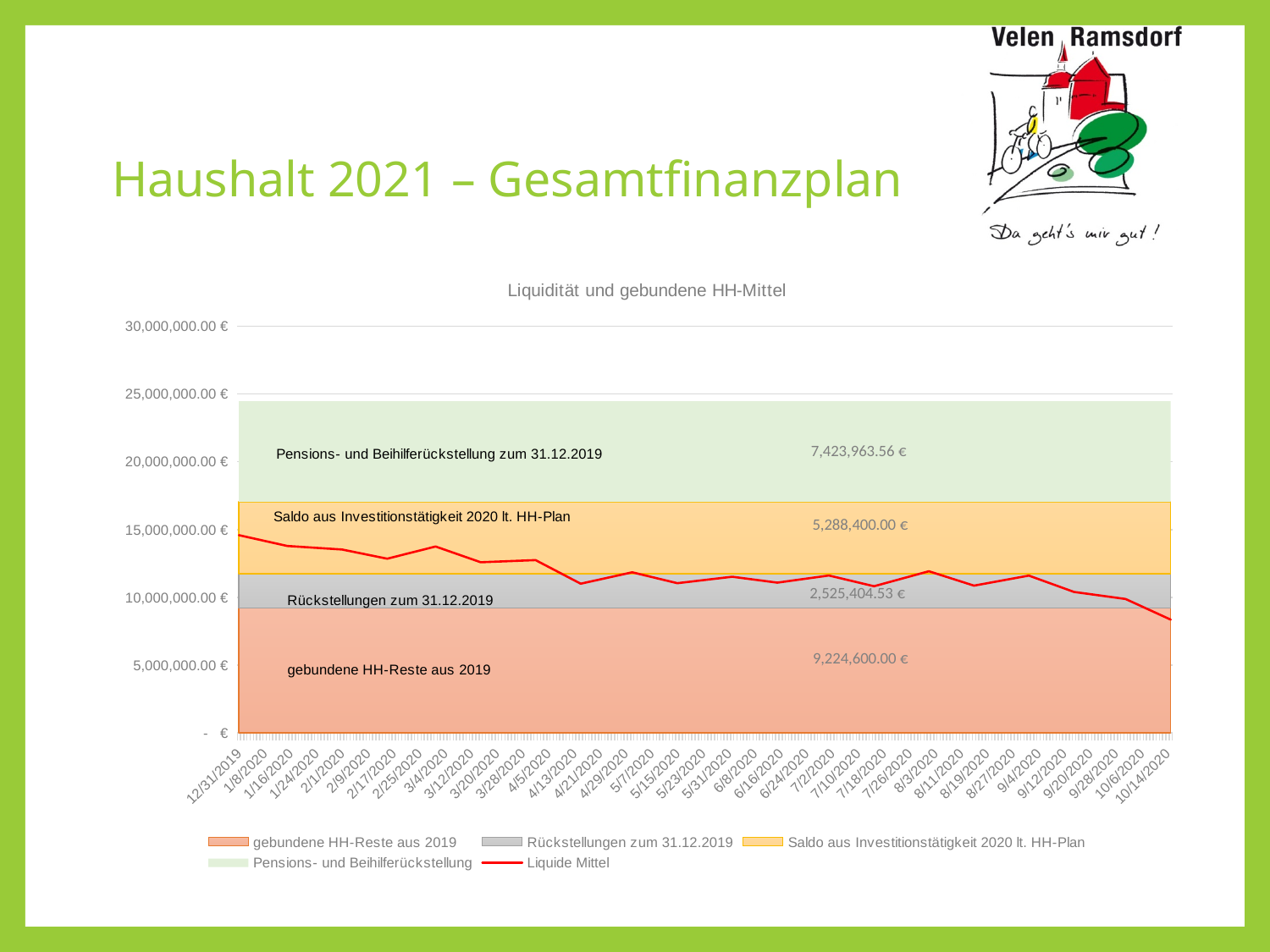
What value is shown for 'Pensions- und Beihilferückstellung zum 31.12.2019'? 7,423,963.56 € Does the 'Liquide Mittel' line rise or fall from 12/31/2019 to 10/14/2020? fall Which of the labelled bands has the smallest value? Rückstellungen zum 31.12.2019 What value is shown for 'gebundene HH-Reste aus 2019'? 9,224,600.00 € What is the total of the four labelled bands stacked in the chart? 24,462,368.09 € What value is shown for 'Rückstellungen zum 31.12.2019'? 2,525,404.53 € What is the difference between the value for 'gebundene HH-Reste aus 2019' and the value for 'Pensions- und Beihilferückstellung zum 31.12.2019'? 1,800,636.44 € Is the value of the 'Liquide Mittel' line at 10/14/2020 greater or less than 10,000,000.00 €? less What value is shown for 'Saldo aus Investitionstätigkeit 2020 lt. HH-Plan'? 5,288,400.00 € How many entries does the legend list? 5 Which of the labelled bands has the largest value? gebundene HH-Reste aus 2019 Which is larger: 'Saldo aus Investitionstätigkeit 2020 lt. HH-Plan' or 'Rückstellungen zum 31.12.2019'? Saldo aus Investitionstätigkeit 2020 lt. HH-Plan